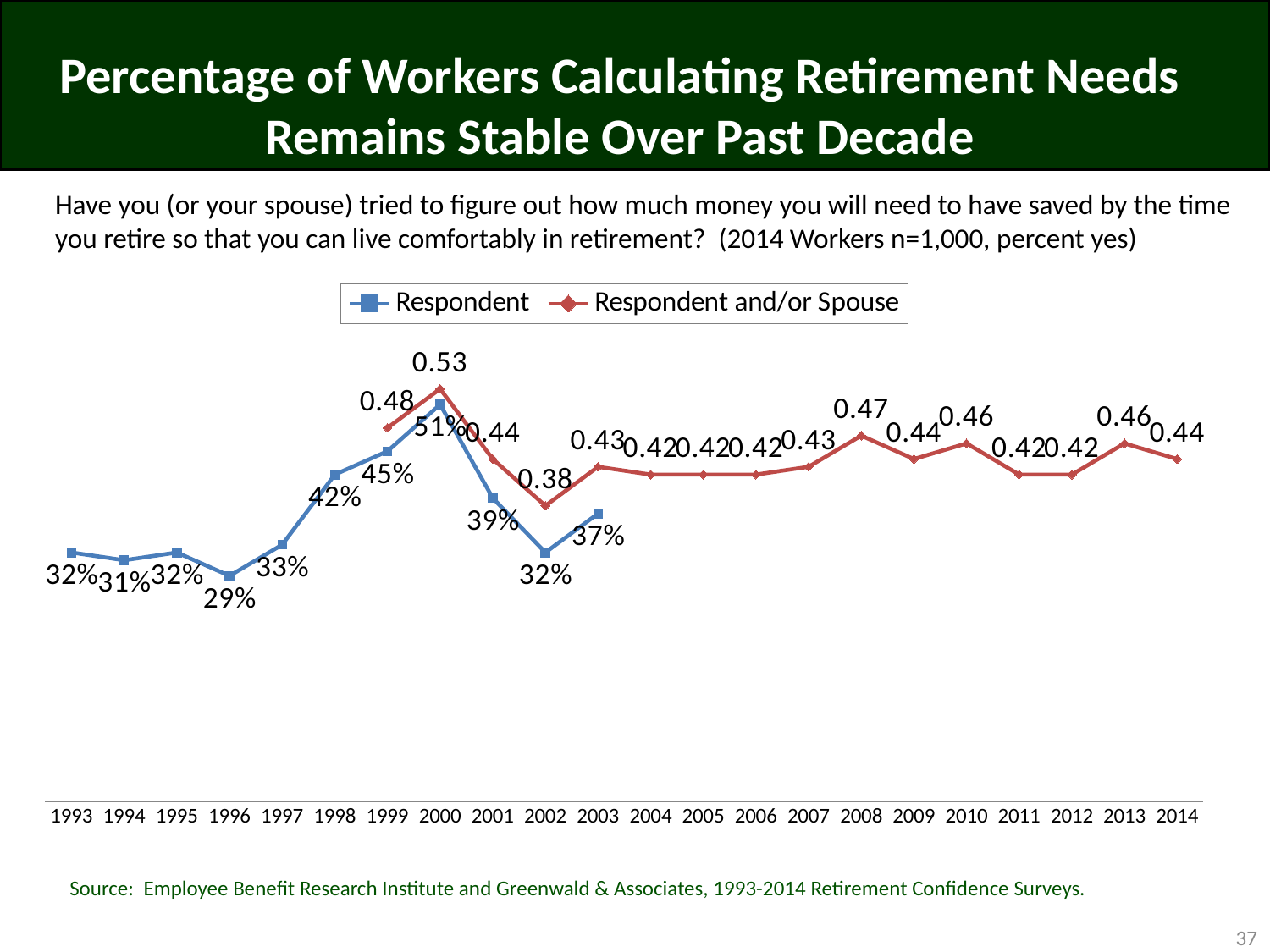
In which year is the Respondent and/or Spouse series at its highest? 2000 What is the value for Respondent and/or Spouse in 2014? 0.44 What is the value for Respondent in 2000? 51% How many series does the legend list? 2 What kind of chart is shown on the slide? line chart What is the value for Respondent and/or Spouse in 2008? 0.47 What is the difference between the Respondent values for 2000 and 1996? 22 percentage points How many years are shown on the x axis? 22 In which year is the Respondent series at its lowest? 1996 Which year has the higher Respondent and/or Spouse value, 2008 or 2009? 2008 What is the value for Respondent in 2002? 32% In which year is the Respondent and/or Spouse series at its lowest? 2002